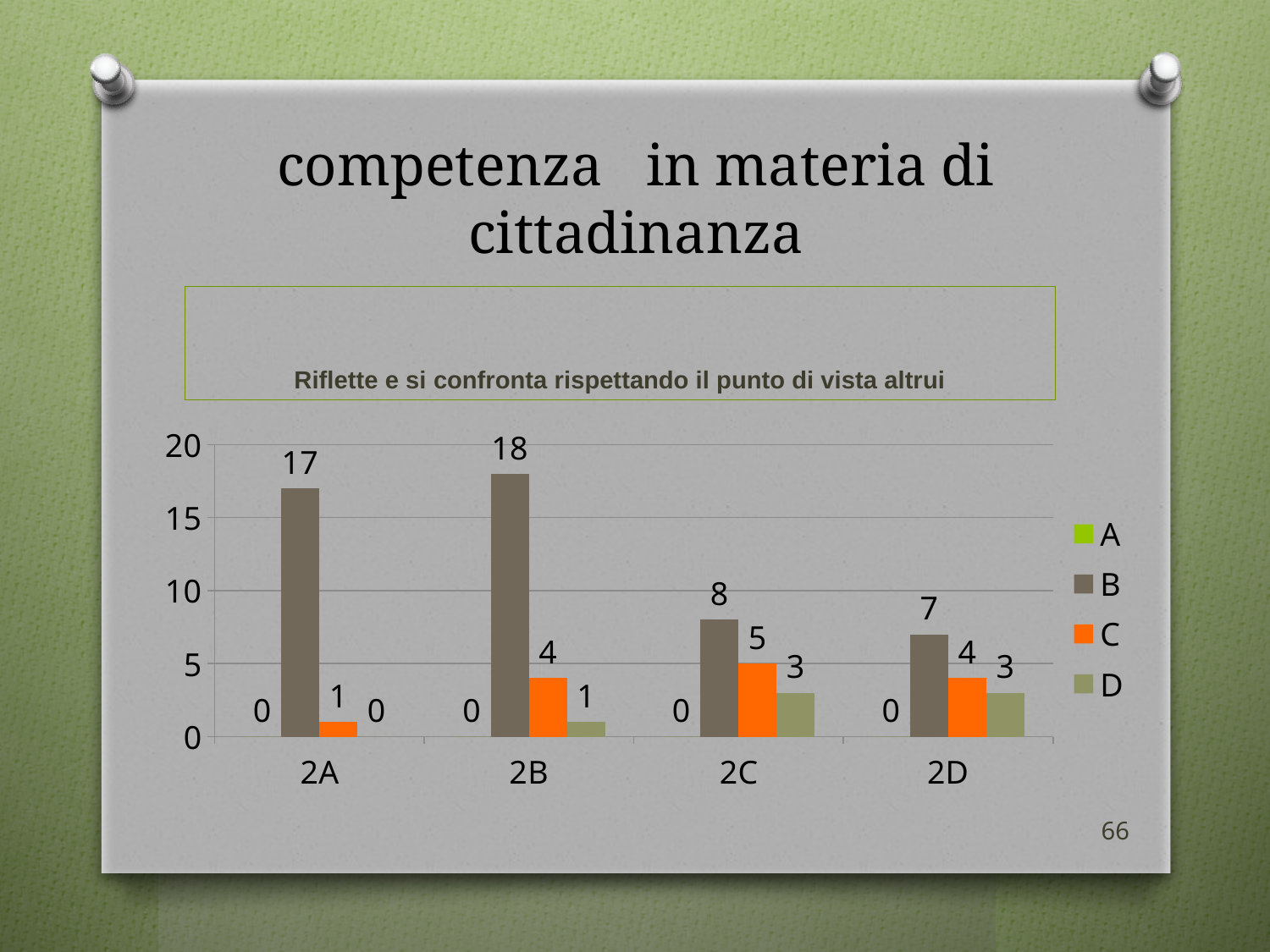
What is the value of series B for category 2A? 17 How many series does the legend list? 4 What is the value of series D for category 2B? 1 What is the value of series C for category 2C? 5 Which category has the highest value for series B? 2B What kind of chart is shown on the slide? bar chart What is the difference between the series B values for 2B and 2C? 10 How many categories are shown on the x axis? 4 Which category has the lowest value for series B? 2D What is the title of the chart? Riflette e si confronta rispettando il punto di vista altrui What is the value of series A for category 2D? 0 Which is larger: the series C value for 2B or the series C value for 2C? 2C